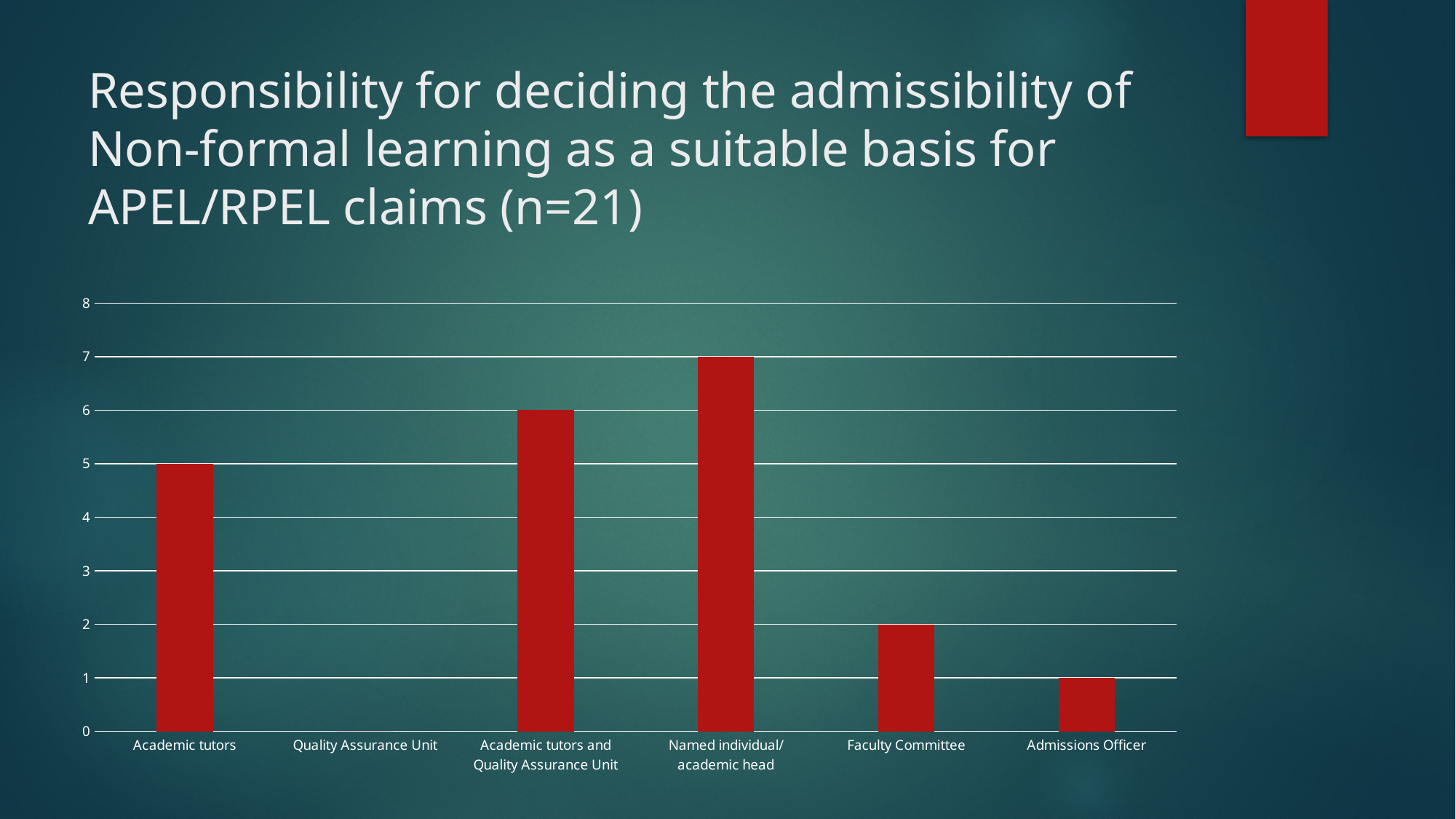
Which category has the lowest value? Quality Assurance Unit What is the value for Named individual/ academic head? 7 What is the value for Academic tutors? 5 What kind of chart is shown on the slide? Bar chart Which is larger, the value for Faculty Committee or the value for Admissions Officer? Faculty Committee What is the difference between the values for Academic tutors and Quality Assurance Unit and Academic tutors? 1 What is the value for Quality Assurance Unit? 0 Which category has the highest value? Named individual/ academic head What is the value for Faculty Committee? 2 What is the value for Admissions Officer? 1 What is the title of the chart on the slide? Responsibility for deciding the admissibility of Non-formal learning as a suitable basis for APEL/RPEL claims (n=21) How many categories are shown on the x axis? 6